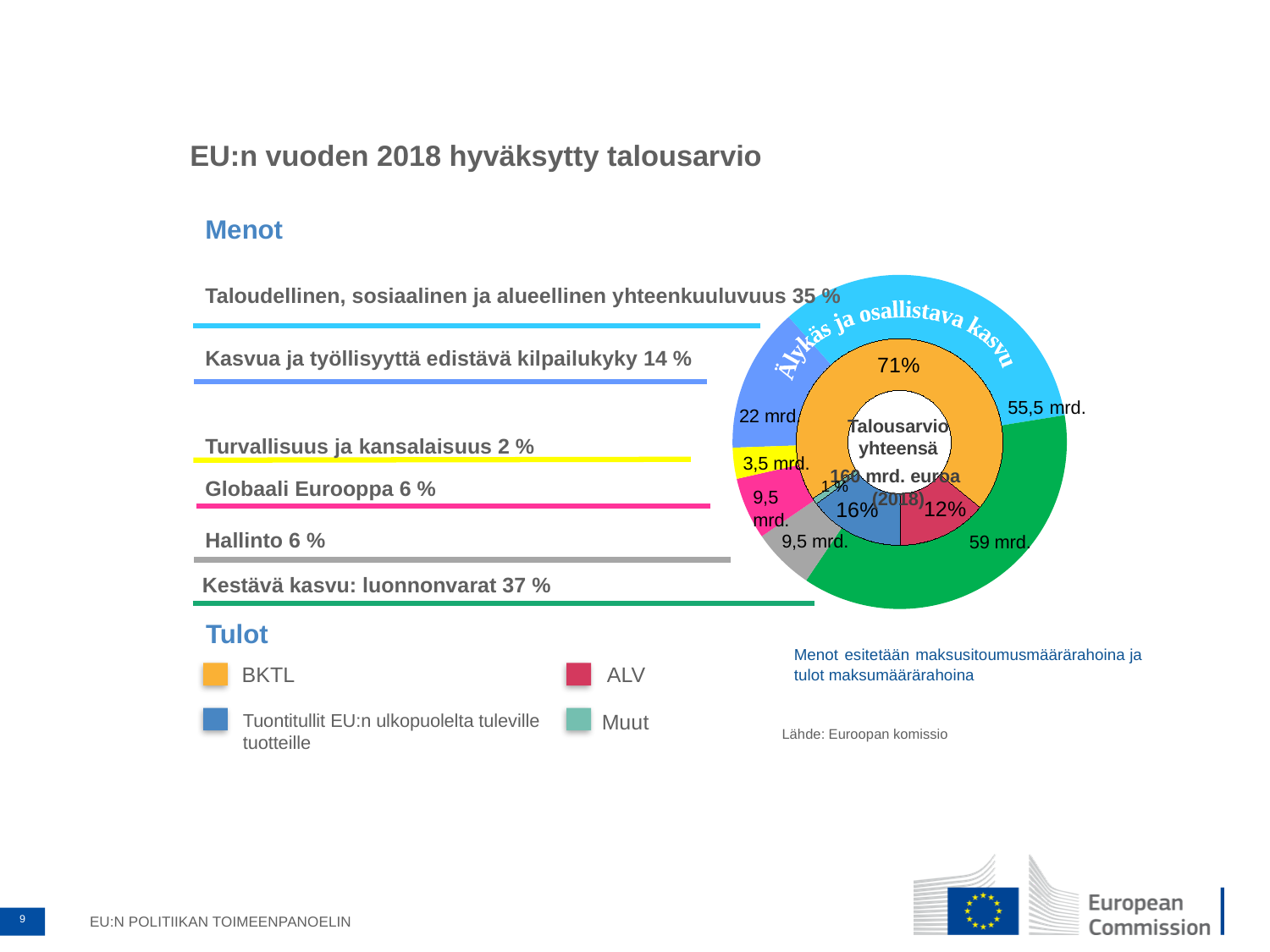
What share of revenue (Tulot) comes from BKTL according to the inner ring? 71% How many revenue sources does the Tulot legend list? 4 What is the largest expenditure value shown on the outer ring? 59 mrd. What is the difference in percentage points between the BKTL share and the Tuontitullit share of revenue? 55 What is the total budget shown in the centre of the doughnut chart? 160 mrd. euroa Which revenue source has the smallest share in the inner ring? Muut What is the smallest expenditure value shown on the outer ring? 3,5 mrd. What share of revenue (Tulot) comes from ALV according to the inner ring? 12% Which revenue source has the largest share in the inner ring? BKTL What kind of chart is shown on the slide? doughnut chart How many expenditure categories (Menot) are listed on the slide? 6 What share of revenue (Tulot) comes from Tuontitullit EU:n ulkopuolelta tuleville tuotteille? 16%